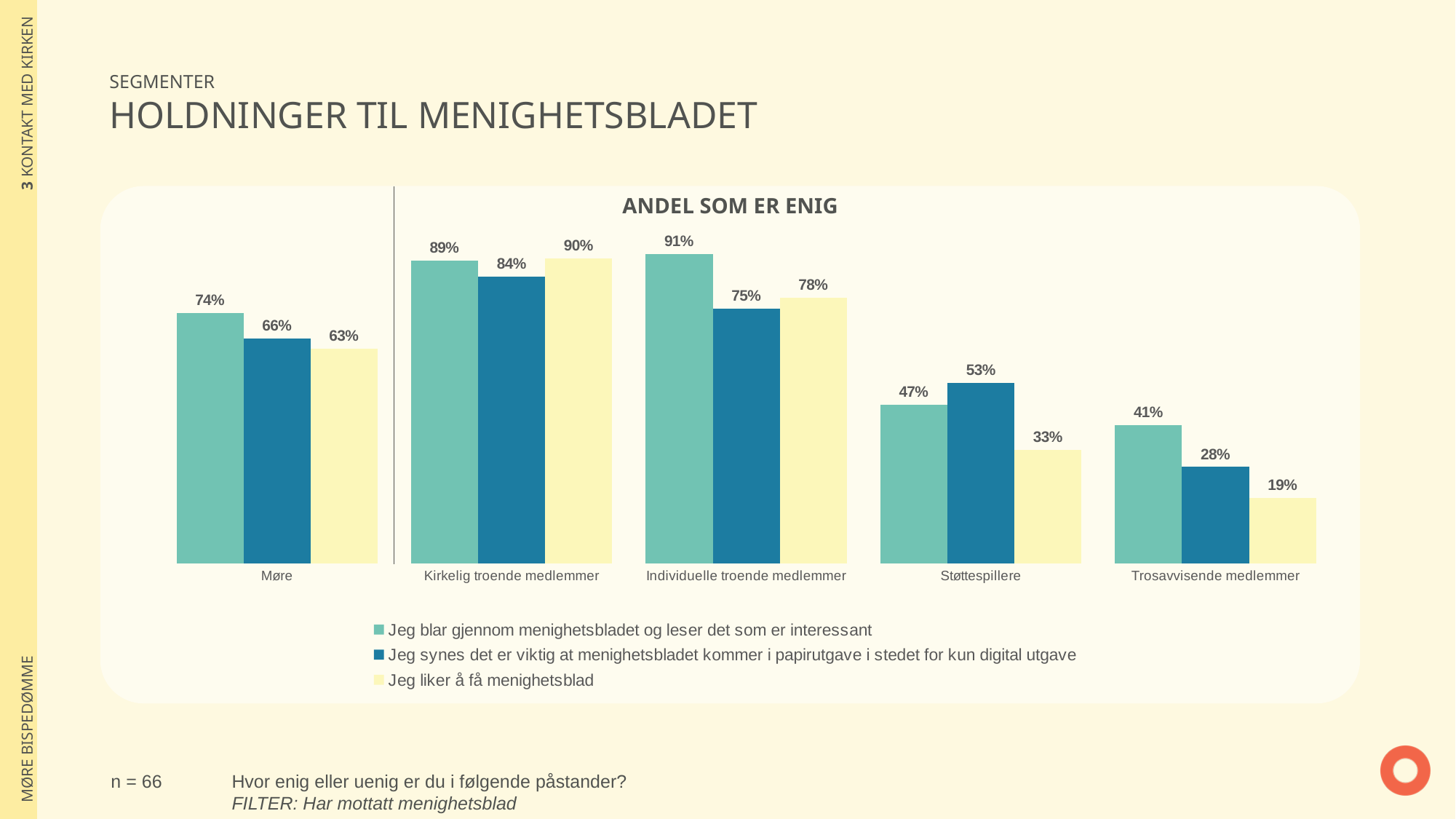
How many categories are shown on the x axis? 5 What is the value for Kirkelig troende medlemmer for the series 'Jeg synes det er viktig at menighetsbladet kommer i papirutgave i stedet for kun digital utgave'? 84% Which category has the highest value for the series 'Jeg liker å få menighetsblad'? Kirkelig troende medlemmer What kind of chart is shown on the slide? Bar chart What is the title of the chart? ANDEL SOM ER ENIG What is the value for Møre for the series 'Jeg blar gjennom menighetsbladet og leser det som er interessant'? 74% For Støttespillere, which is larger: the value for 'Jeg blar gjennom menighetsbladet og leser det som er interessant' or the value for 'Jeg synes det er viktig at menighetsbladet kommer i papirutgave i stedet for kun digital utgave'? Jeg synes det er viktig at menighetsbladet kommer i papirutgave i stedet for kun digital utgave What is the value for Støttespillere for the series 'Jeg liker å få menighetsblad'? 33% What is the value for Trosavvisende medlemmer for the series 'Jeg synes det er viktig at menighetsbladet kommer i papirutgave i stedet for kun digital utgave'? 28% How many series does the legend list? 3 Which category has the lowest value for the series 'Jeg blar gjennom menighetsbladet og leser det som er interessant'? Trosavvisende medlemmer What is the difference between the 'Jeg blar gjennom menighetsbladet og leser det som er interessant' value and the 'Jeg liker å få menighetsblad' value for Individuelle troende medlemmer? 13%